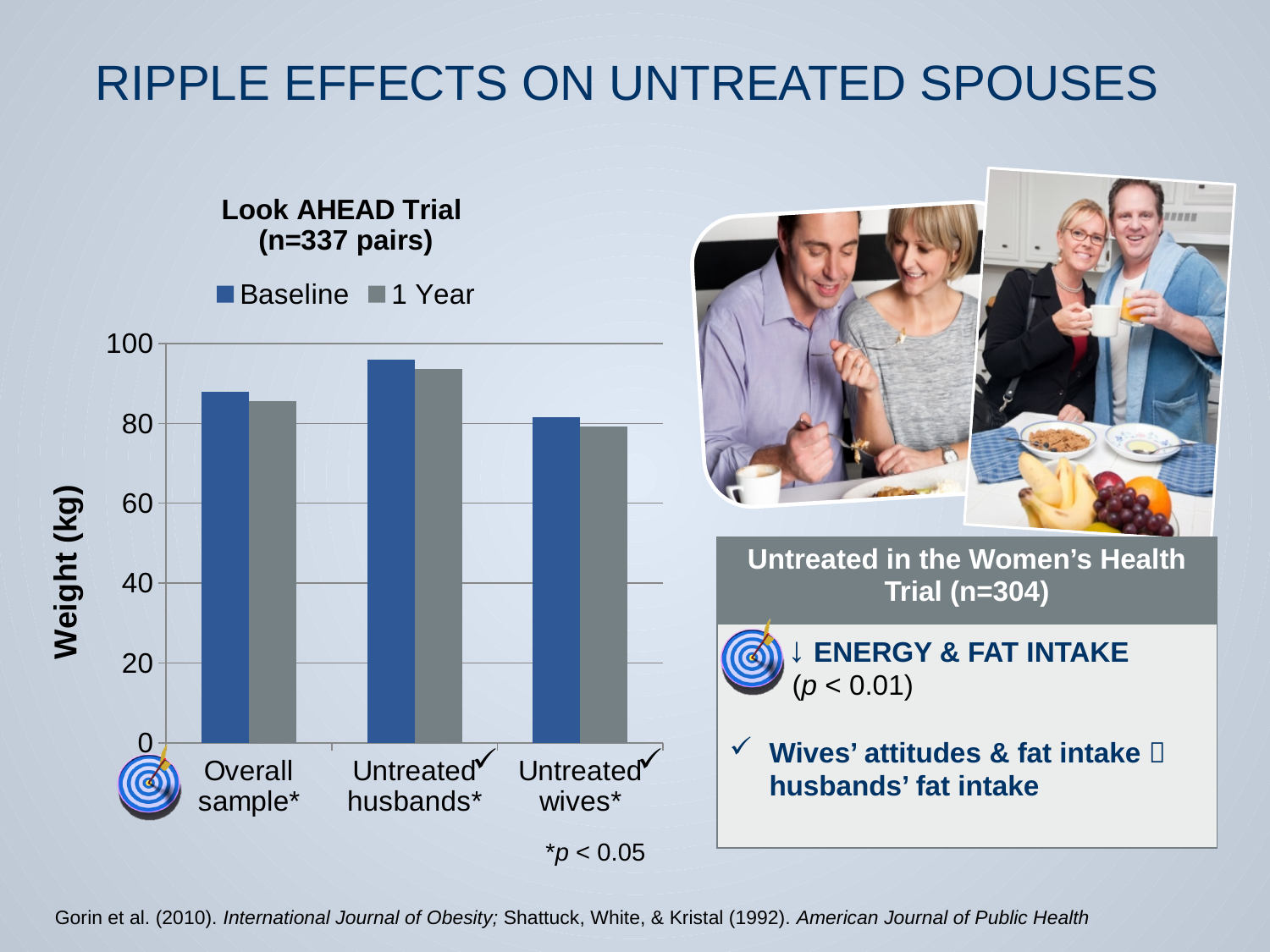
How many series does the chart legend list? 2 For Untreated husbands, which is larger: the Baseline weight or the 1 Year weight? Baseline What kind of chart is shown on the slide? Bar chart Is the 1 Year weight for the Overall sample greater or less than 80 kg? greater How many categories are shown on the x axis of the chart? 3 Is the Baseline weight for Untreated husbands greater or less than 80 kg? greater What is the label on the y axis of the chart? Weight (kg) Is the Baseline weight for Untreated wives greater or less than 100 kg? less Which category has the lowest 1 Year weight? Untreated wives* From Baseline to 1 Year, does the weight rise or fall in each category? Fall Which category has the highest Baseline weight? Untreated husbands* What is the title of the chart? Look AHEAD Trial (n=337 pairs)